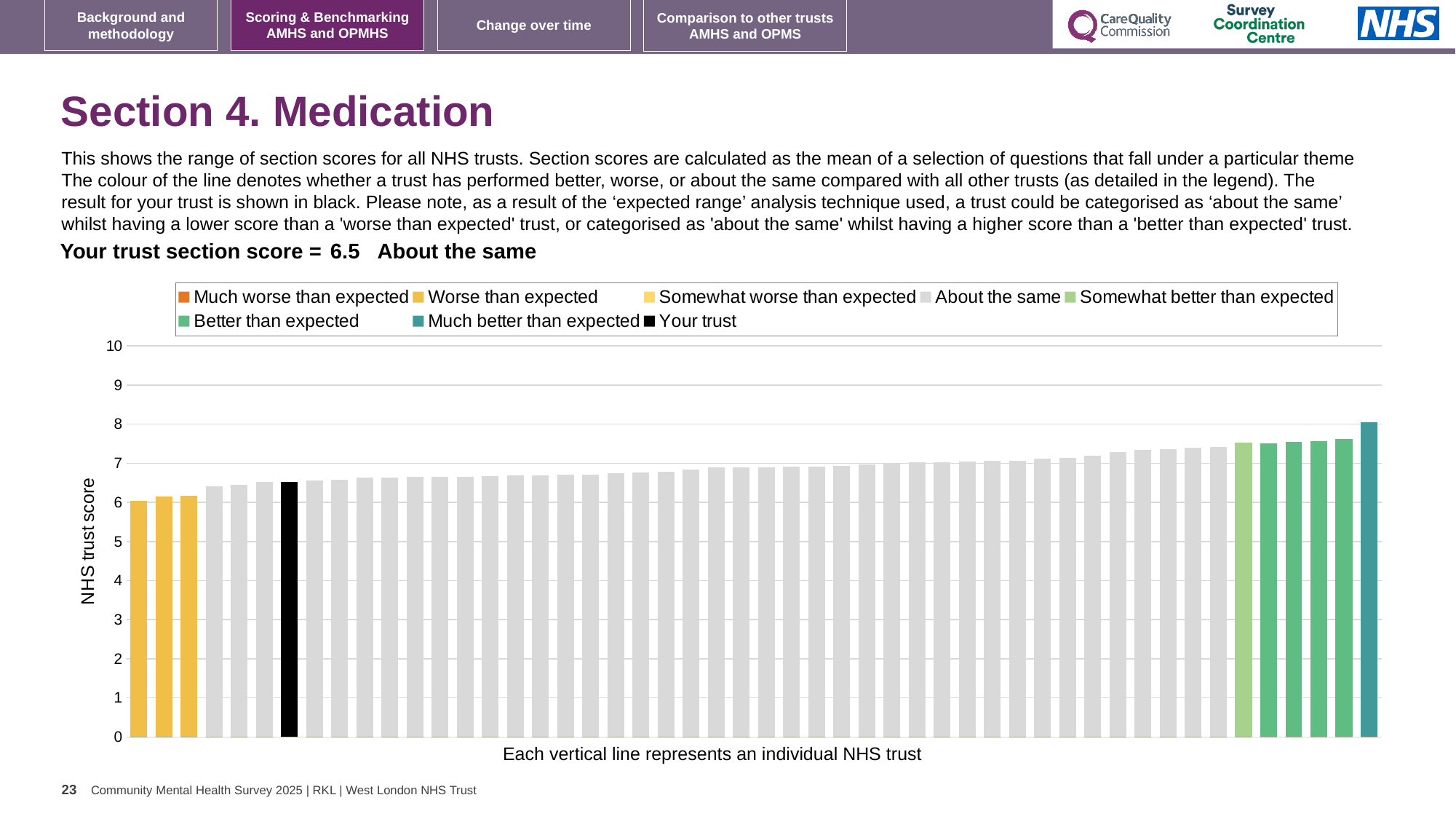
How many entries does the chart legend list? 8 Is the value for your trust greater or less than 6? greater What is the label on the y axis of the chart? NHS trust score Do the bar values rise or fall from left to right along the x axis? rise Is the value of the shortest bar greater or less than 7? less Which legend category does the tallest bar belong to? Much better than expected Which legend category do the shortest bars belong to? Worse than expected How many bars are coloured as 'Worse than expected'? 3 What type of chart is shown on the slide? Bar chart Is the value of the tallest bar greater or less than 7? greater Which category is your trust placed in for the Medication section? About the same What is the section score for your trust shown on the slide? 6.5